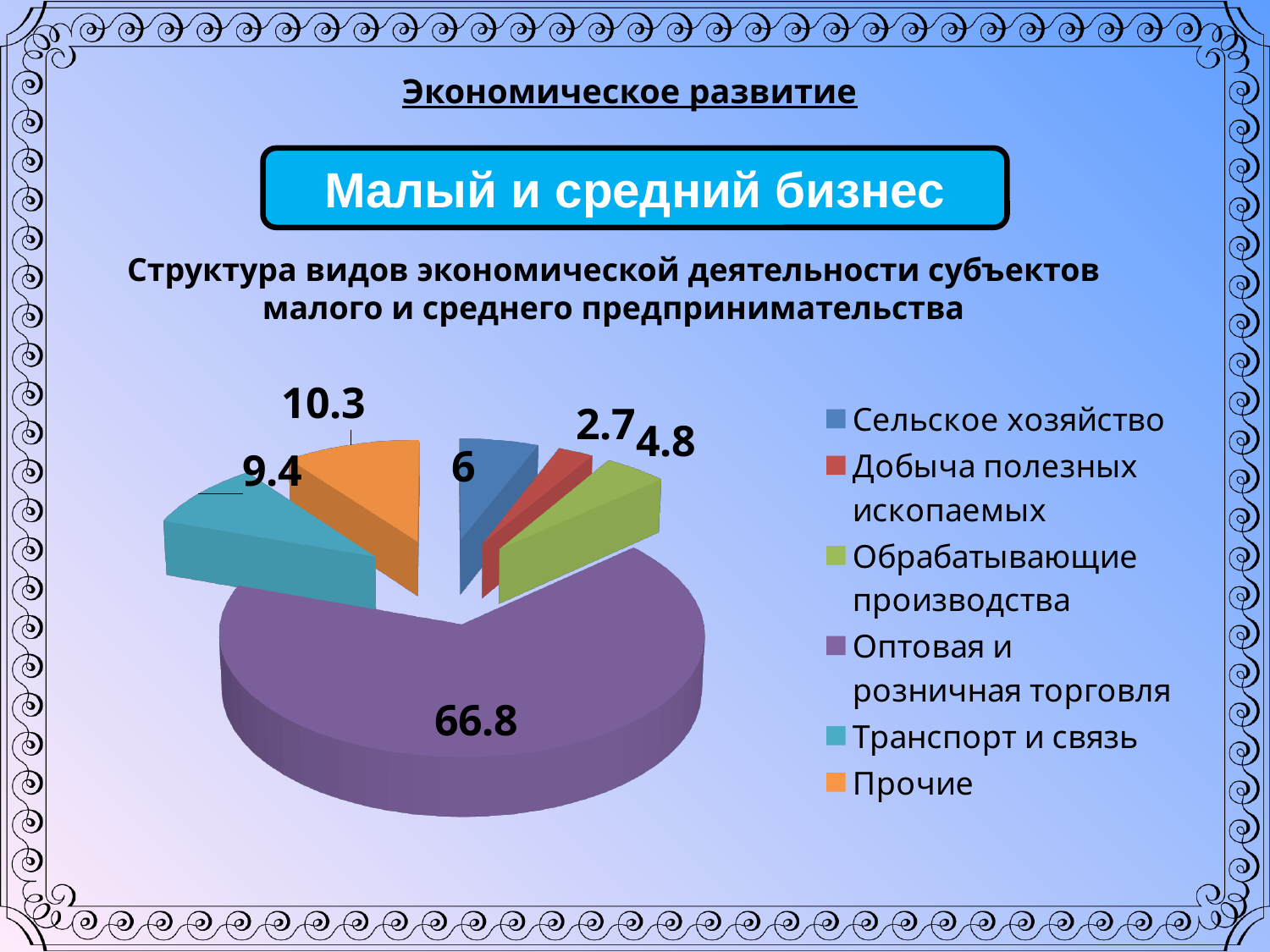
Which category has the smallest slice of the pie? Добыча полезных ископаемых Which category has the largest slice of the pie? Оптовая и розничная торговля What is the value for Оптовая и розничная торговля? 66.8 What colour is the slice for Оптовая и розничная торговля? Purple What is the value for Добыча полезных ископаемых? 2.7 What is the difference between the values for Прочие and Транспорт и связь? 0.9 Which is larger: Сельское хозяйство or Обрабатывающие производства? Сельское хозяйство What is the value for Транспорт и связь? 9.4 What is the difference between the values for Сельское хозяйство and Добыча полезных ископаемых? 3.3 How many categories does the pie chart have? 6 What type of chart is shown on the slide? Pie chart What is the value for Прочие? 10.3